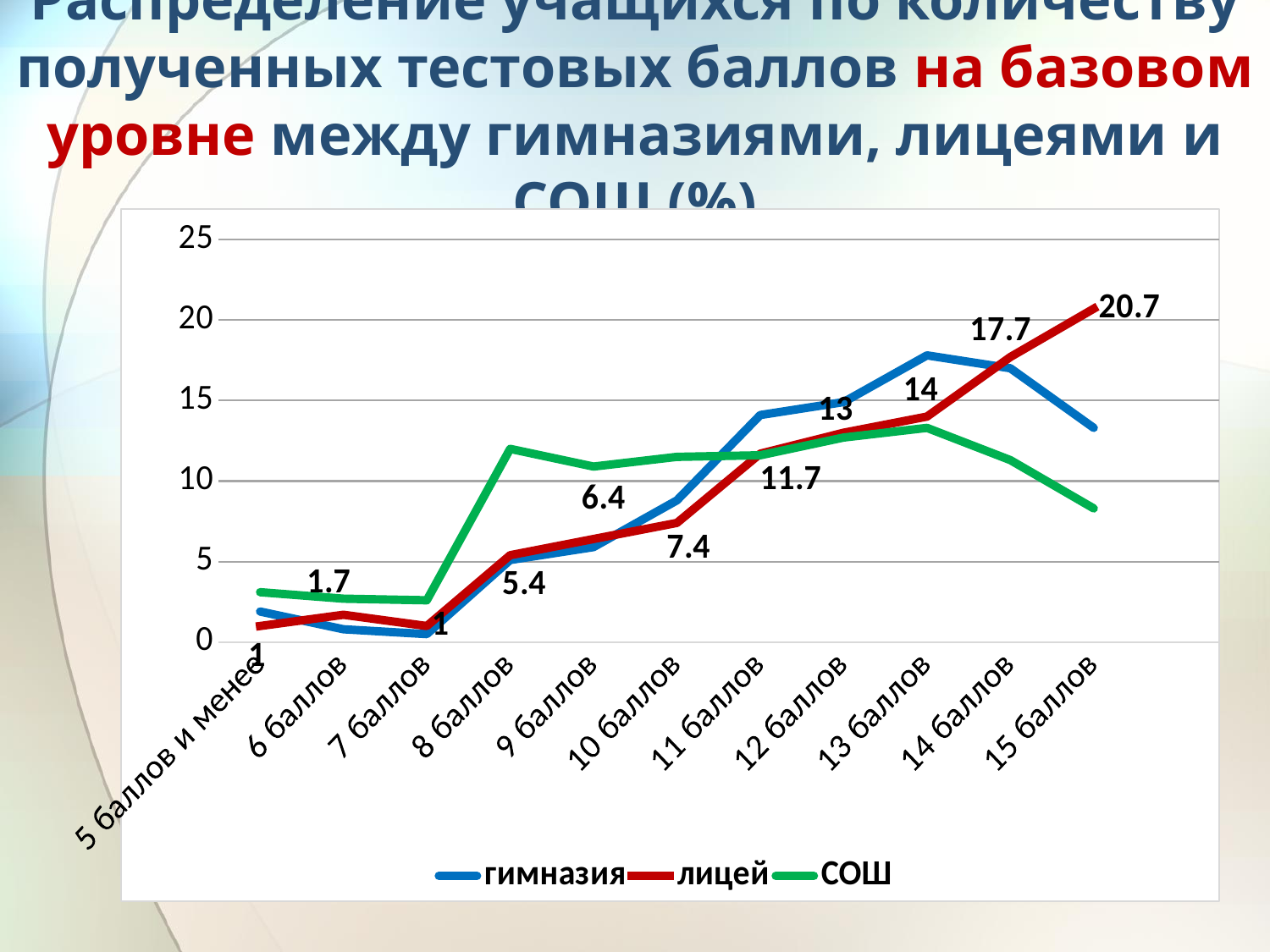
What kind of chart is shown on the slide? line chart How many series does the legend list? 3 Which is larger for лицей: the value at 12 баллов or at 13 баллов? 13 баллов Which colour is used for the СОШ series? green How many score categories are shown on the x axis? 11 What is the value for лицей at 8 баллов? 5.4 Is the value for СОШ at 15 баллов greater or less than 10? less Is the value for гимназия at 13 баллов greater or less than 15? greater At which score category does the лицей series reach its highest value? 15 баллов What is the value for лицей at 11 баллов? 11.7 What is the difference between the лицей values at 15 баллов and 14 баллов? 3 What is the value for лицей at 15 баллов? 20.7